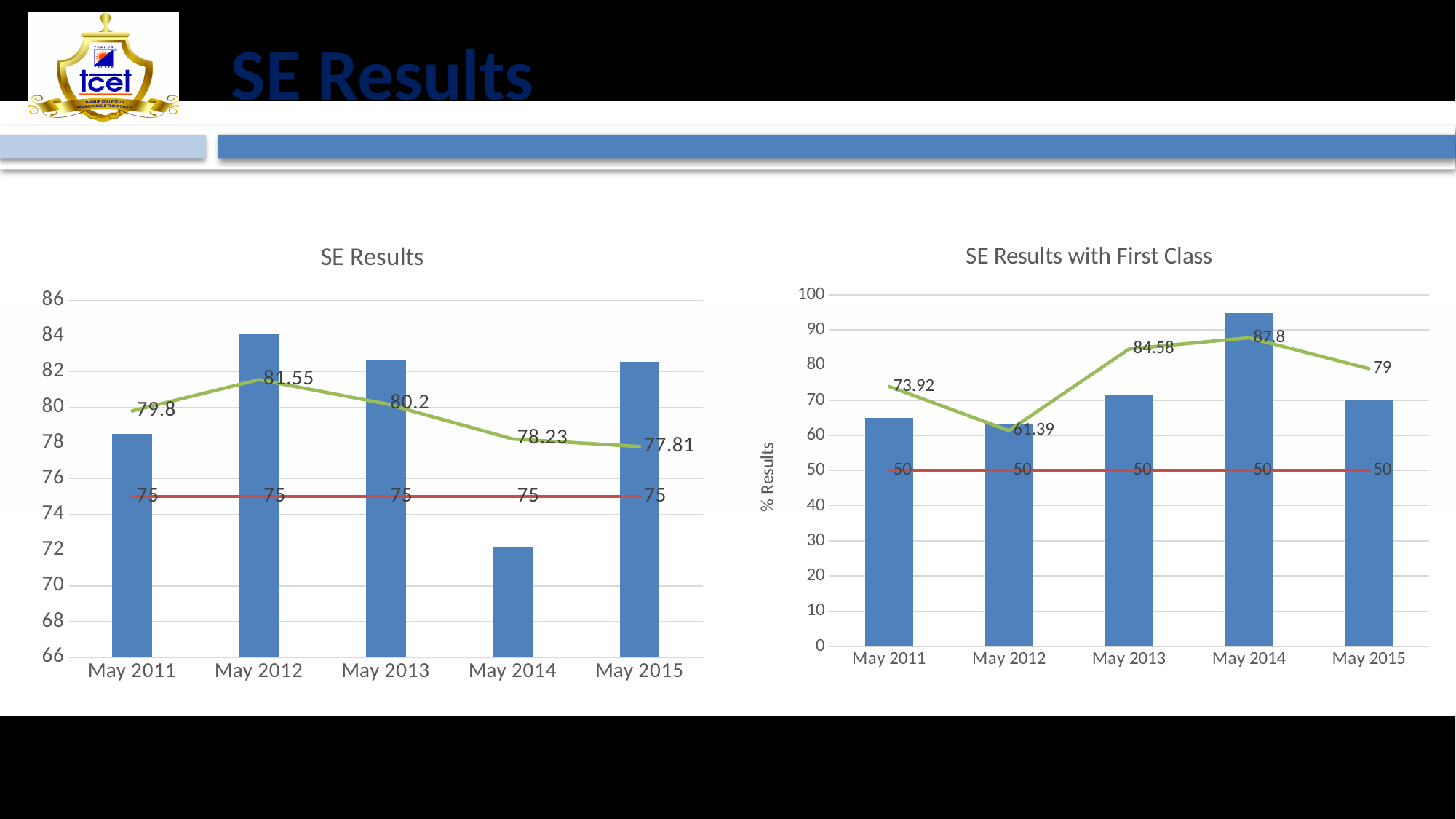
In the 'SE Results with First Class' chart on the right, what is the difference between the green line values for May 2014 and May 2011? 13.88 In the 'SE Results with First Class' chart on the right, is the bar for May 2014 greater or less than 90? greater In the 'SE Results' chart on the left, is the bar for May 2012 greater or less than 82? greater How many years are shown on the x axis of the 'SE Results with First Class' chart on the right? 5 In the 'SE Results' chart on the left, what is the difference between the green line values for May 2012 and May 2015? 3.74 In the 'SE Results' chart on the left, is the bar for May 2014 greater or less than 74? less In the 'SE Results' chart on the left, in which year does the green line reach its highest value? May 2012 In the 'SE Results' chart on the left, what constant value does the red line show across all years? 75 In the 'SE Results' chart on the left, what value does the green line show for May 2012? 81.55 In the 'SE Results with First Class' chart on the right, in which year is the green line value lowest? May 2012 In the 'SE Results with First Class' chart on the right, what value does the green line show for May 2013? 84.58 In the 'SE Results' chart on the left, in which year does the green line reach its lowest value? May 2015